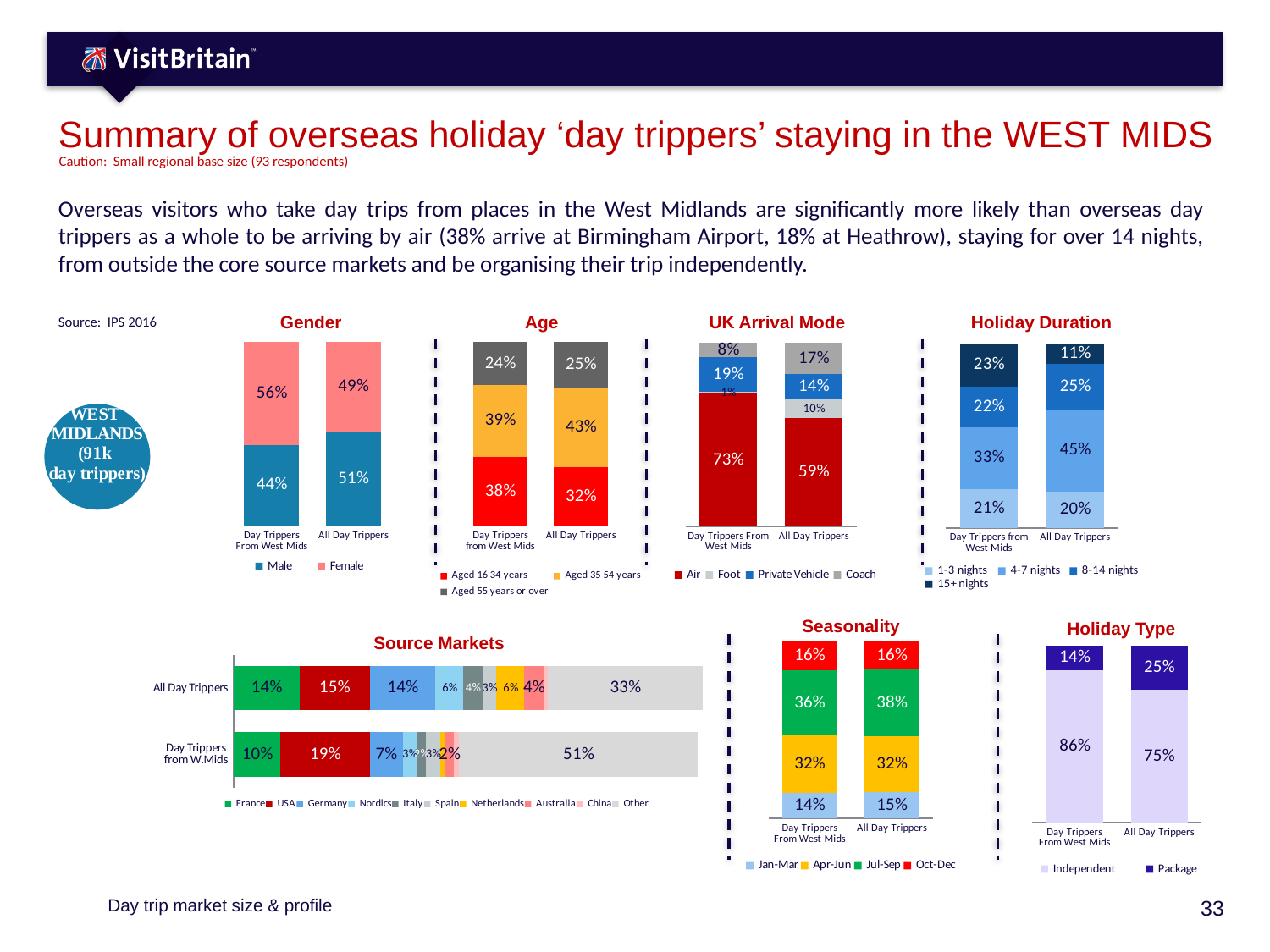
In the Age chart, which age group is the smallest for Day Trippers from West Mids? Aged 55 years or over In the Age chart, what percentage of All Day Trippers are Aged 35-54 years? 43% In the Source Markets chart, what is the share of Other for All Day Trippers? 33% In the UK Arrival Mode chart, what percentage of Day Trippers From West Mids arrive by Air? 73% In the Gender chart, what is the difference between the Female share for Day Trippers From West Mids and for All Day Trippers? 7 percentage points In the Holiday Duration chart, what percentage of All Day Trippers stay 4-7 nights? 45% In the Holiday Type chart, what percentage of All Day Trippers travel on a Package holiday? 25% In the Gender chart, what percentage of Day Trippers From West Mids are Male? 44% In the Source Markets chart, what percentage of Day Trippers from W.Mids come from the USA? 19% In the Holiday Duration chart, which group has the larger share staying 15+ nights, Day Trippers from West Mids or All Day Trippers? Day Trippers from West Mids In the Seasonality chart, what percentage of Day Trippers From West Mids travel in Jul-Sep? 36% In the UK Arrival Mode chart, how many series does the legend list? 4